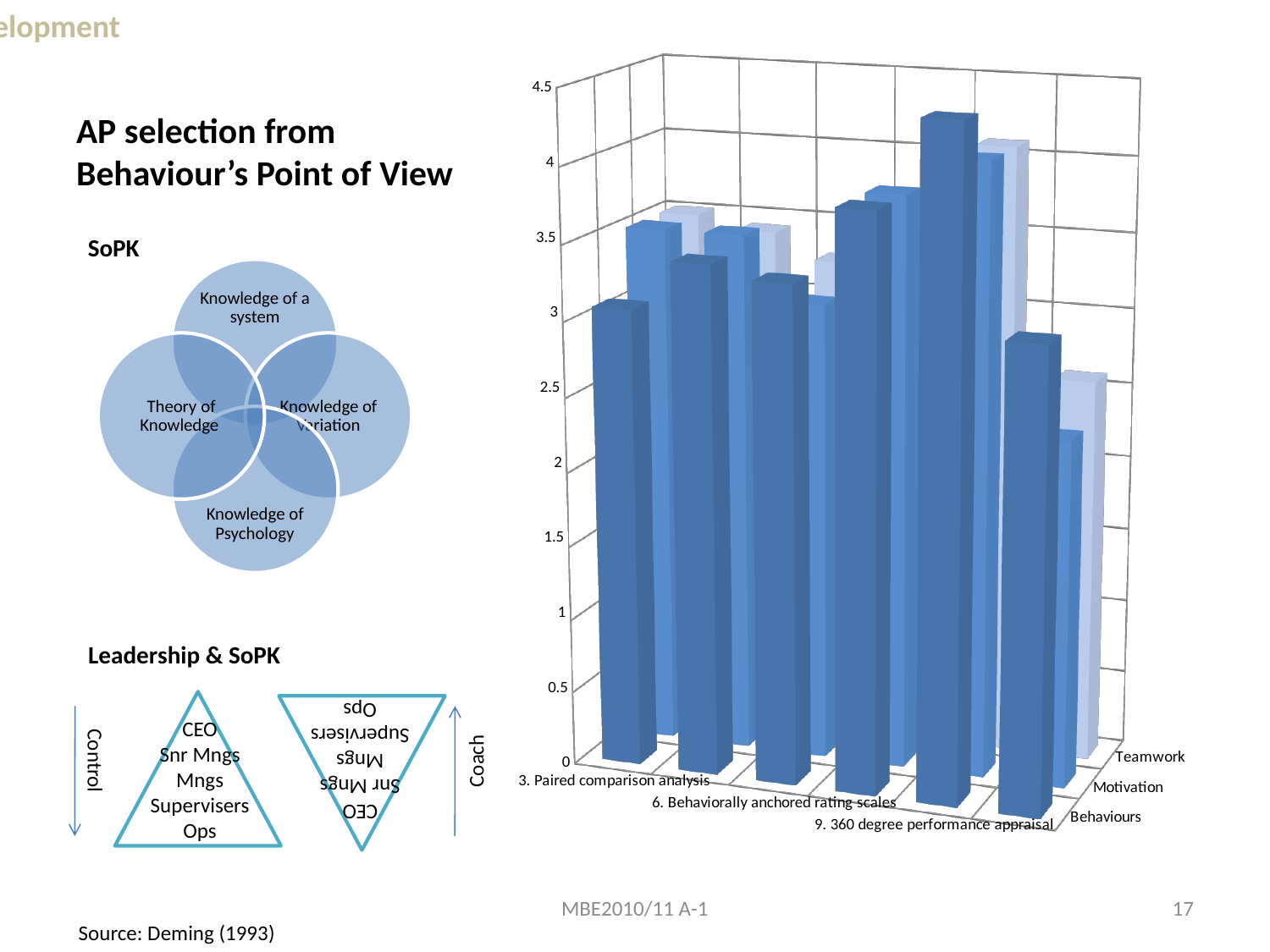
Is the tallest Behaviours bar in the chart greater or less than 4? greater Is the Teamwork bar in the rightmost group of the chart greater or less than 3? less How many groups of bars are plotted along the horizontal axis of the bar chart? 6 What are the three series names shown on the depth axis of the bar chart? Behaviours, Motivation, Teamwork Which series is plotted in the front row of the bar chart? Behaviours What is the highest value shown on the vertical axis of the bar chart? 4.5 How many series are plotted along the depth axis of the bar chart? 3 What kind of chart is shown on the right side of the slide? bar chart